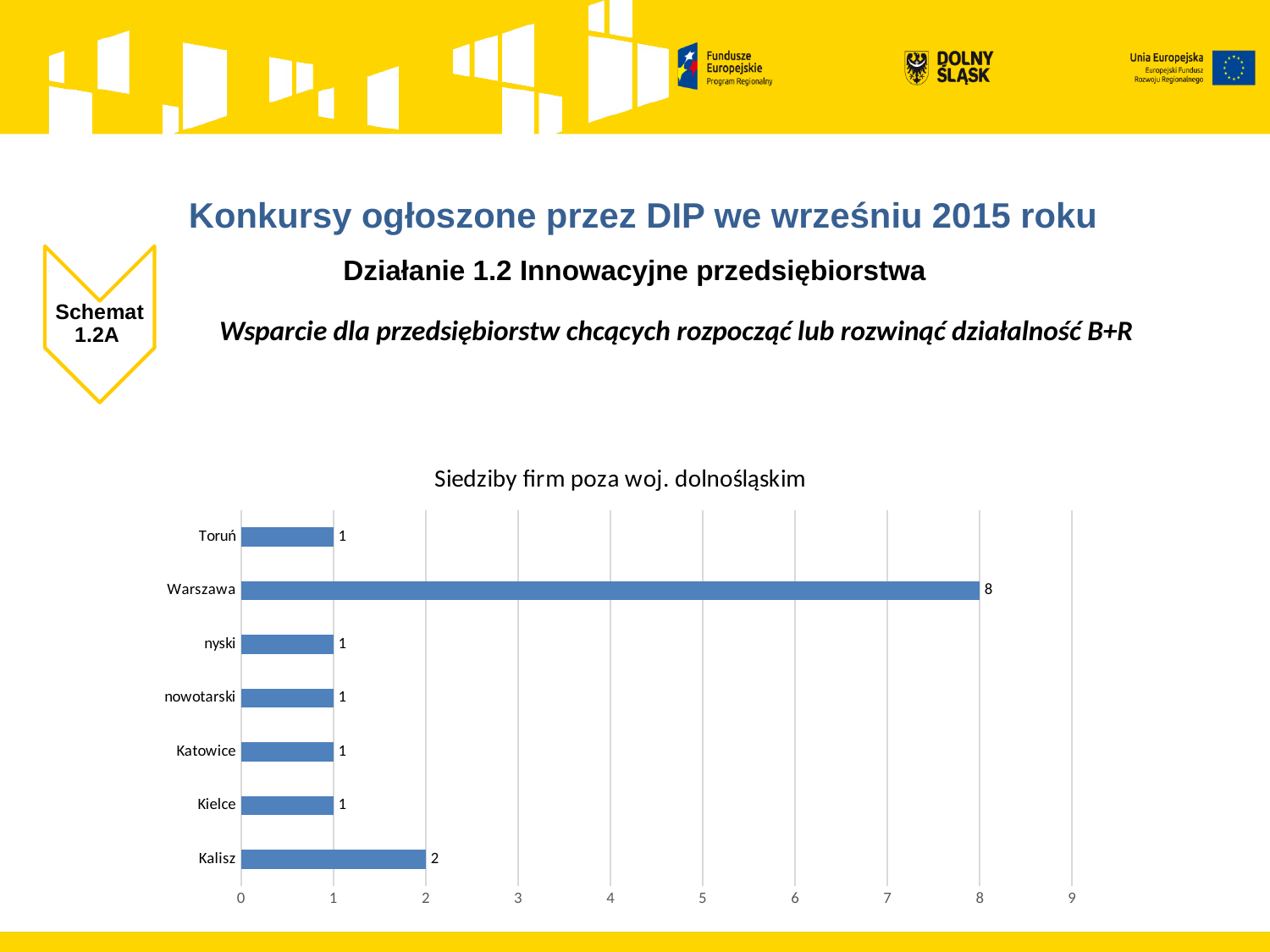
Is the value for Warszawa greater or less than 5? greater What kind of chart is shown on the slide? bar chart What is the value for Warszawa? 8 How many categories have a value of 1? 5 What is the title of the chart? Siedziby firm poza woj. dolnośląskim What is the value for Kielce? 1 What is the value for Kalisz? 2 Which is larger, the value for Kalisz or the value for Katowice? Kalisz What is the difference between the values for Warszawa and Kalisz? 6 What is the value for Toruń? 1 Which category has the highest value? Warszawa How many categories are shown on the chart? 7